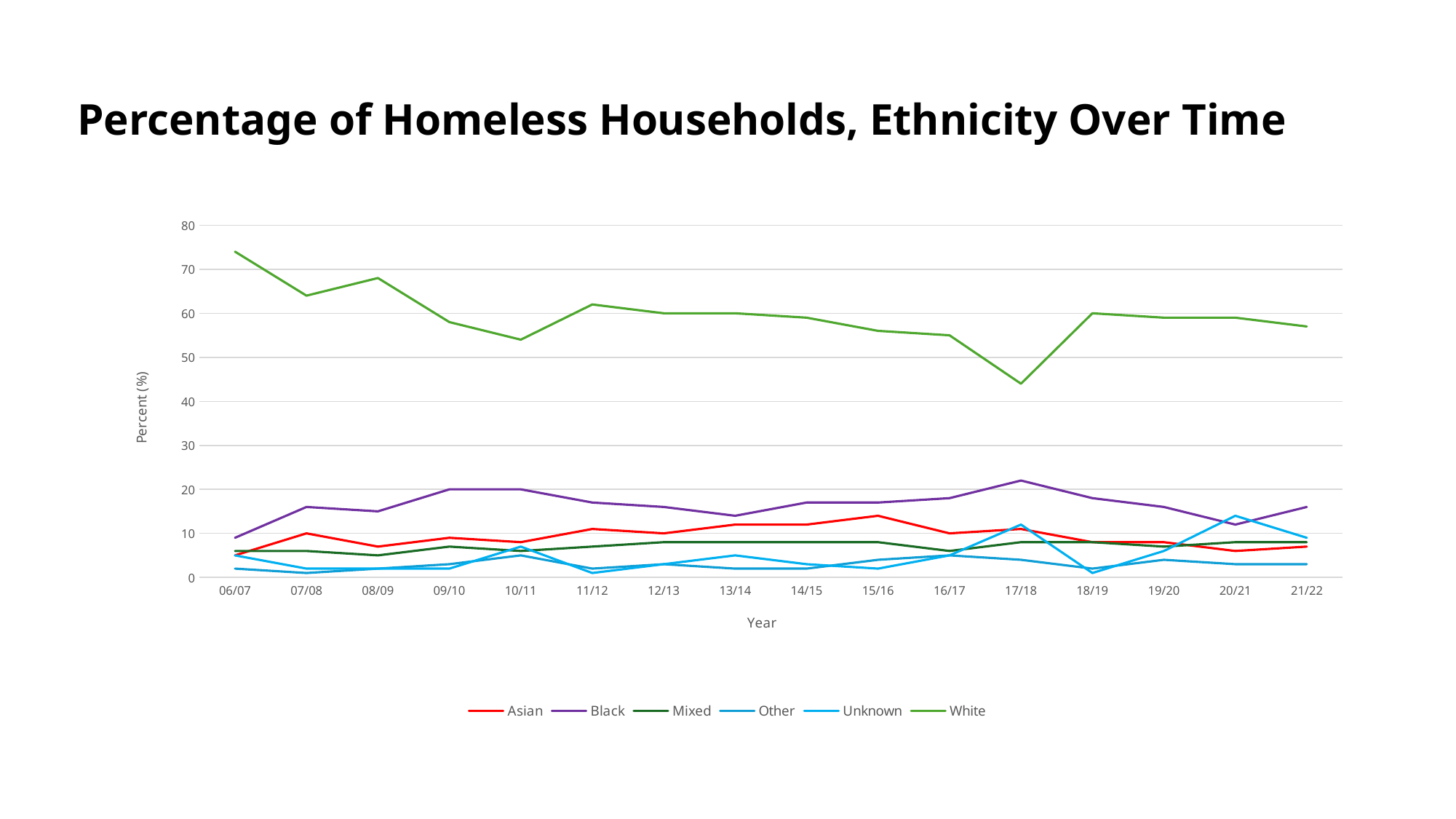
How many years are shown along the x axis? 16 What kind of chart is shown on the slide? line chart Is the value for White in 17/18 greater or less than 50? less Is the value for Black in 17/18 greater or less than 20? greater Which ethnicity has the highest percentage of homeless households across all years? White Is the value for White in 06/07 greater or less than 70? greater What is the label on the y axis? Percent (%) How many series does the legend list? 6 In which year does the White series reach its lowest value? 17/18 Which is larger in 21/22, the value for Black or the value for Asian? Black Does the White series rise or fall from 06/07 to 07/08? fall